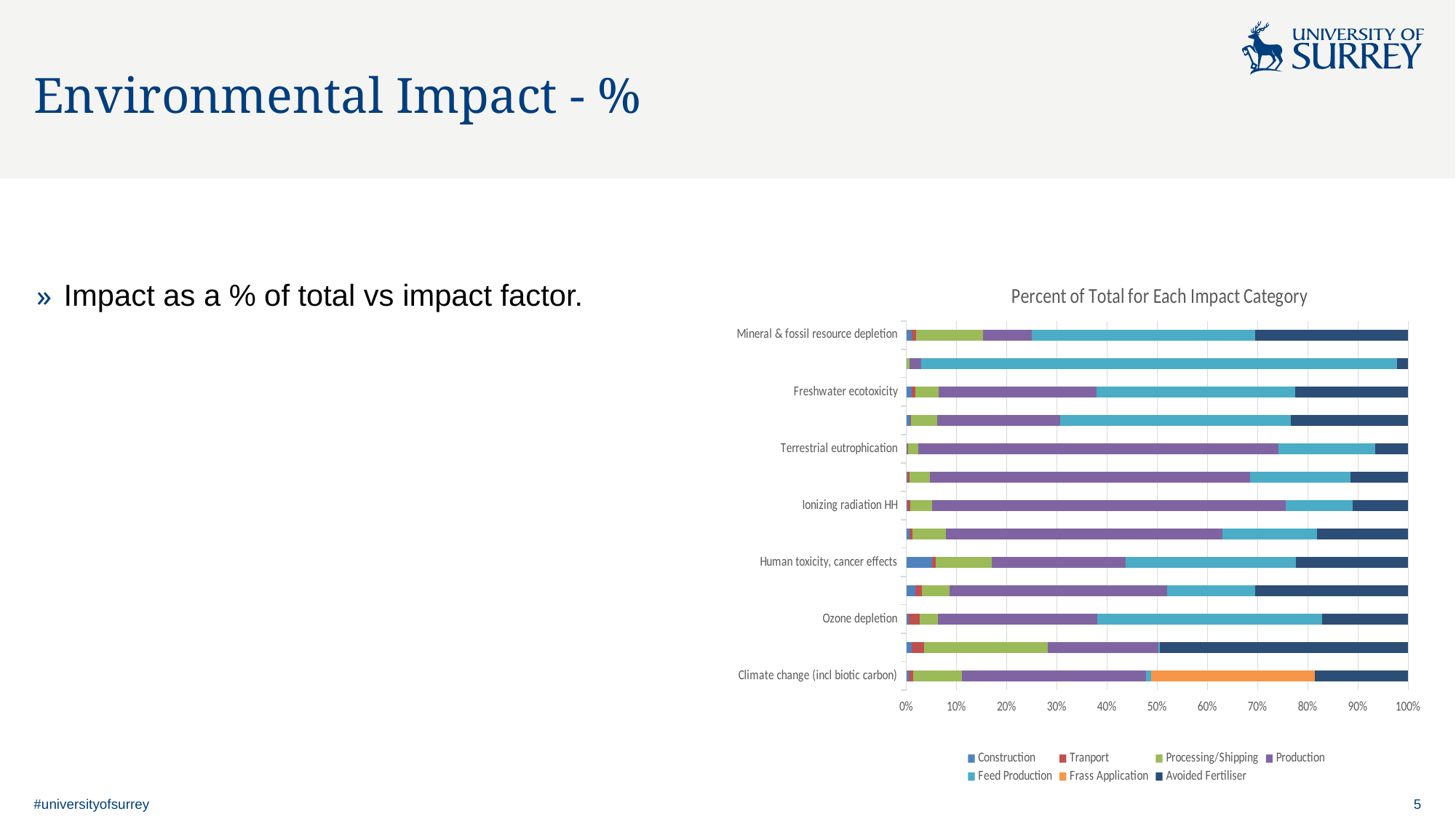
How many series does the chart's legend list? 7 For Terrestrial eutrophication, which is larger: the Production share or the Feed Production share? Production Is the Production share for Terrestrial eutrophication greater or less than 60%? greater Is the Frass Application share for Climate change (incl biotic carbon) greater or less than 20%? greater Is the Avoided Fertiliser share for Mineral & fossil resource depletion greater or less than 20%? greater What kind of chart is shown on the slide? Stacked bar chart How many bars are plotted in the chart? 13 Which series appears only in the Climate change (incl biotic carbon) bar? Frass Application For Mineral & fossil resource depletion, which is larger: the Feed Production share or the Processing/Shipping share? Feed Production What value does each stacked bar total on the x axis? 100% What is the title of the chart? Percent of Total for Each Impact Category